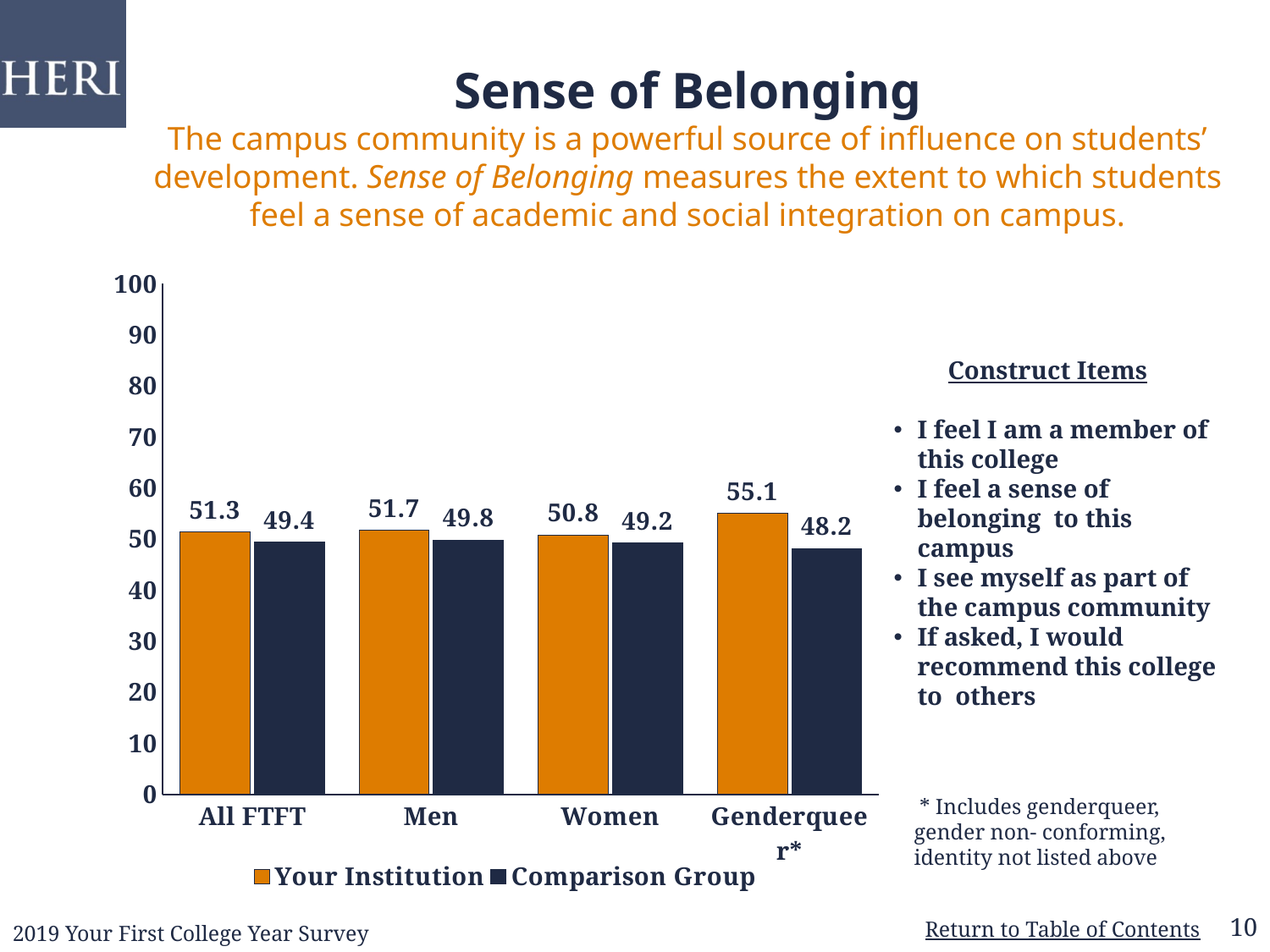
What colour are the Comparison Group bars? Dark navy blue How many categories are shown on the x axis? 4 Which category has the lowest Comparison Group value? Genderqueer* Which is larger for Women: the Your Institution value or the Comparison Group value? Your Institution What kind of chart is shown on the slide? Bar chart What is the Comparison Group value for Women? 49.2 What is the Your Institution value for Men? 51.7 What is the Comparison Group value for All FTFT? 49.4 What is the Your Institution value for Genderqueer*? 55.1 How many series does the legend list? 2 Which category has the highest Your Institution value? Genderqueer* What is the difference between the Your Institution and Comparison Group values for Genderqueer*? 6.9